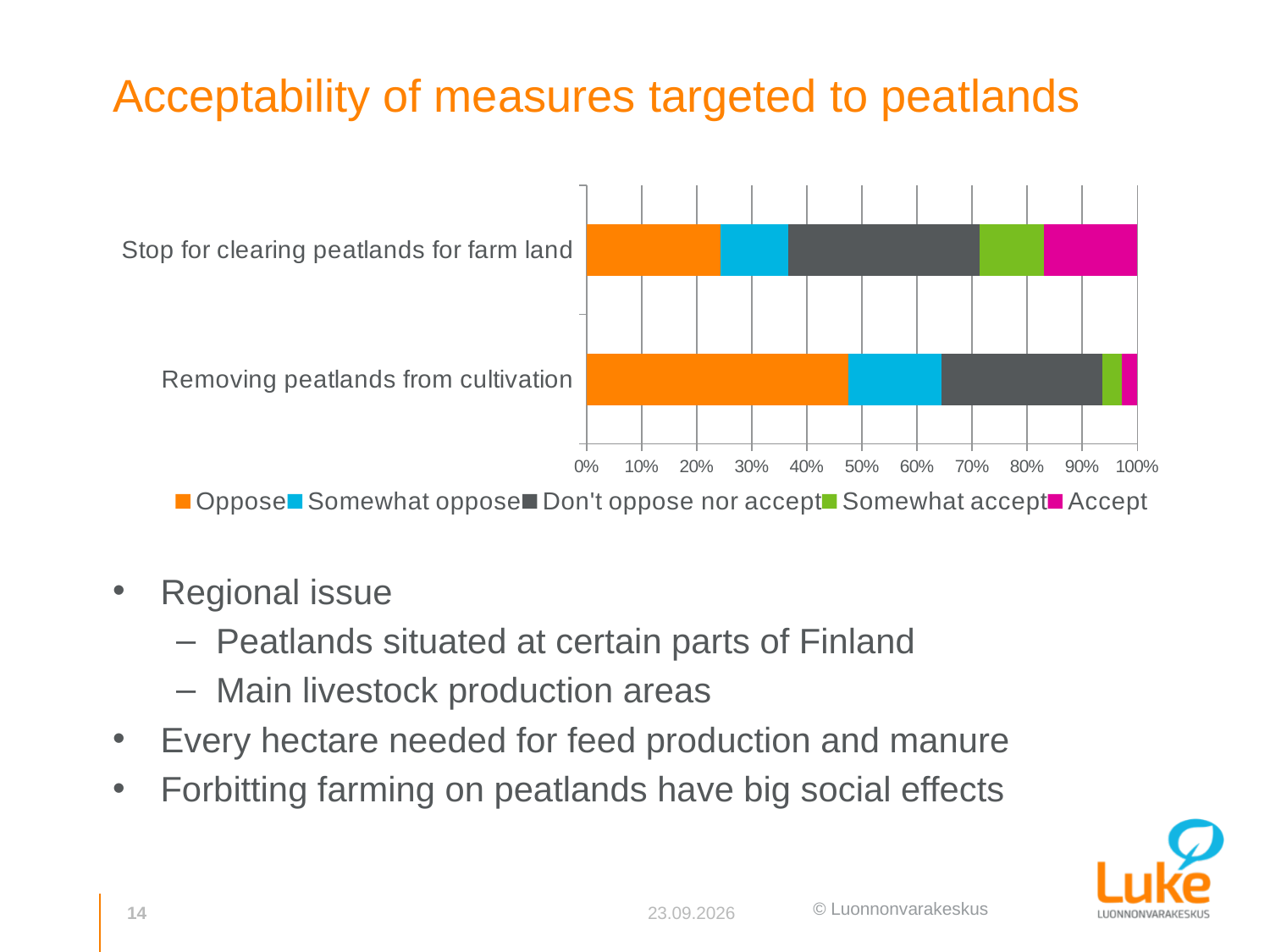
Is the 'Accept' share for 'Stop for clearing peatlands for farm land' greater or less than 10%? greater Is the 'Oppose' share for 'Stop for clearing peatlands for farm land' greater or less than 30%? less Is the 'Accept' share for 'Removing peatlands from cultivation' greater or less than 10%? less Which measure has the larger 'Accept' share: 'Stop for clearing peatlands for farm land' or 'Removing peatlands from cultivation'? Stop for clearing peatlands for farm land What kind of chart is shown on the slide? Stacked bar chart Which colour represents the 'Oppose' series in the chart? Orange How many categories (measures) are plotted in the chart? 2 What is the title of the slide containing the chart? Acceptability of measures targeted to peatlands How many series does the chart legend list? 5 Which measure has the larger 'Oppose' share: 'Stop for clearing peatlands for farm land' or 'Removing peatlands from cultivation'? Removing peatlands from cultivation Which measure has the larger 'Somewhat accept' share? Stop for clearing peatlands for farm land